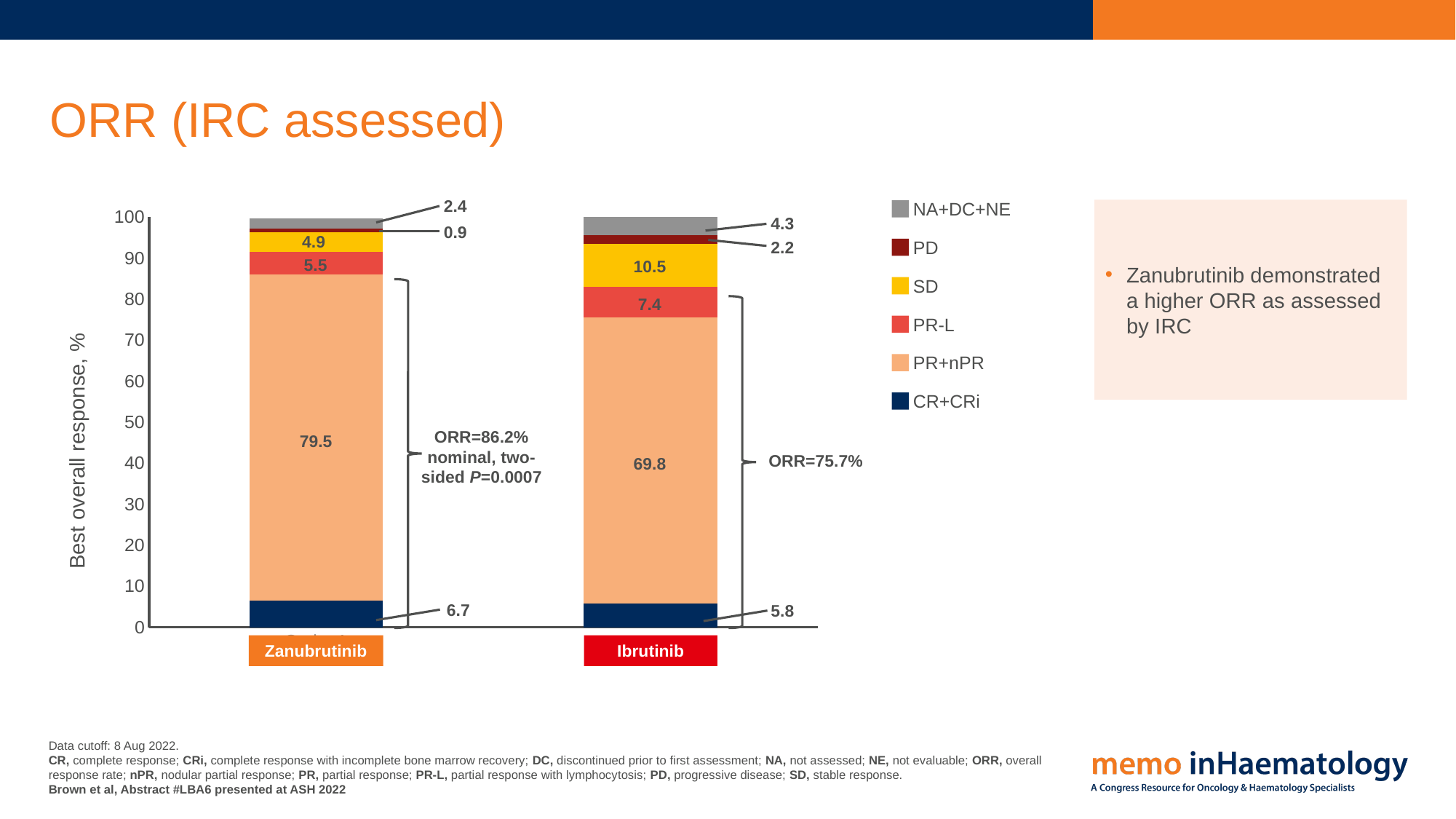
What ORR is shown for Ibrutinib? ORR=75.7% How many series does the legend list? 6 What is the SD value for Ibrutinib? 10.5 What is the PR+nPR value for Zanubrutinib? 79.5 What is the CR+CRi value for Ibrutinib? 5.8 How many treatment groups are shown on the x axis? 2 What is the difference between the SD values for Ibrutinib and Zanubrutinib? 5.6 What kind of chart is shown on the slide? Stacked bar chart What is the difference between the PR+nPR values for Zanubrutinib and Ibrutinib? 9.7 What is the label of the y axis? Best overall response, % Which treatment has the larger PR-L value, Zanubrutinib or Ibrutinib? Ibrutinib What is the NA+DC+NE value for Zanubrutinib? 2.4